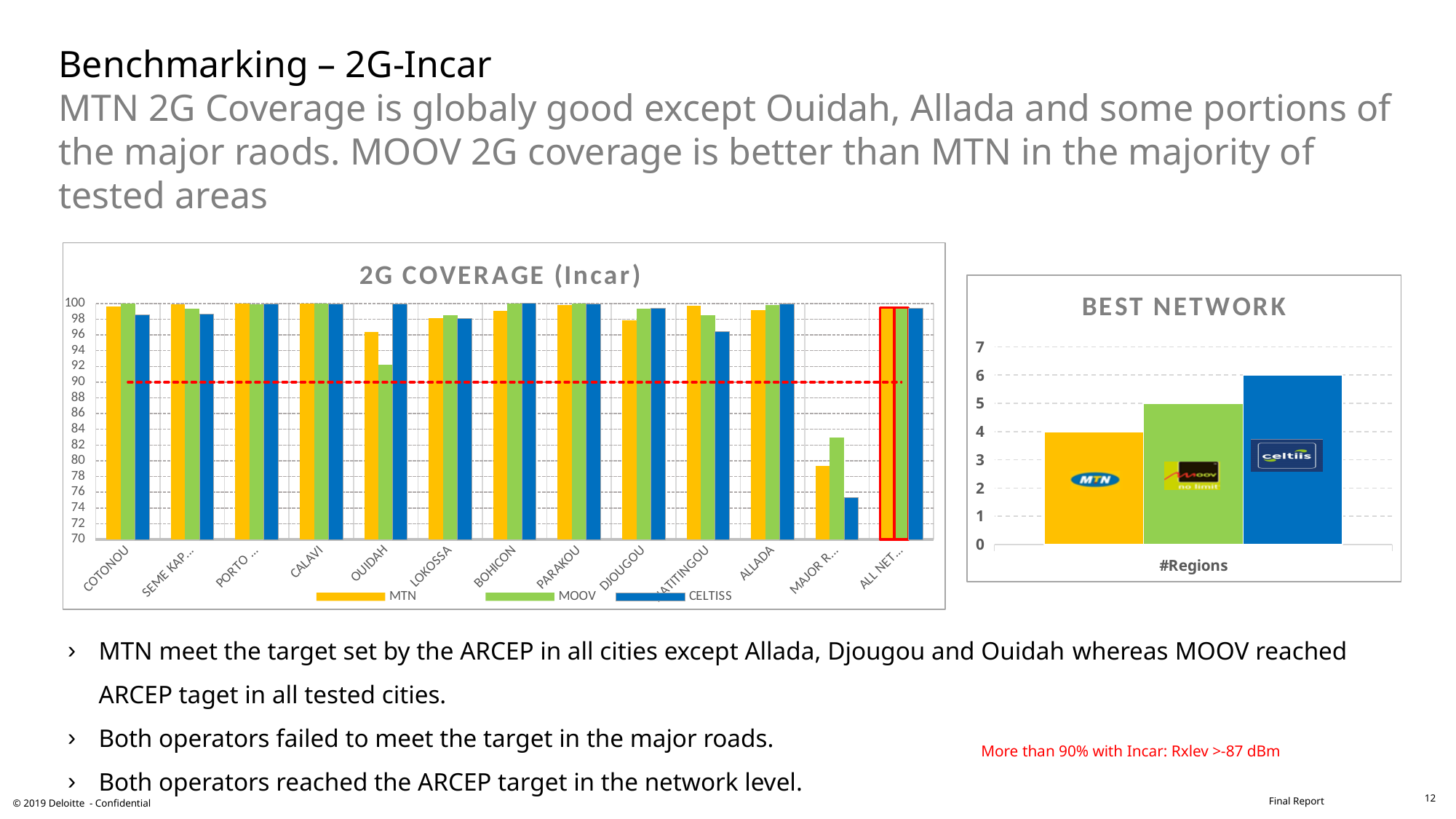
In the '2G COVERAGE (Incar)' chart, which is larger for MAJOR R...: the MOOV value or the CELTISS value? MOOV What kind of chart is the '2G COVERAGE (Incar)' chart? combination bar and line chart In the '2G COVERAGE (Incar)' chart, is the MTN value for MAJOR R... greater or less than 90? less In the '2G COVERAGE (Incar)' chart, which is larger for OUIDAH: the MTN value or the MOOV value? MTN How many series does the legend of the '2G COVERAGE (Incar)' chart list? 3 In the '2G COVERAGE (Incar)' chart, is the MTN value for OUIDAH greater or less than 90? greater In the '2G COVERAGE (Incar)' chart, which category has the lowest MTN value? MAJOR R... In the '2G COVERAGE (Incar)' chart, is the CELTISS value for MAJOR R... greater or less than 80? less In the 'BEST NETWORK' chart, which network has the highest number of regions? CELTISS How many categories are shown on the x axis of the '2G COVERAGE (Incar)' chart? 13 What is the x-axis label of the 'BEST NETWORK' chart? #Regions In the 'BEST NETWORK' chart, which network has the lowest number of regions? MTN